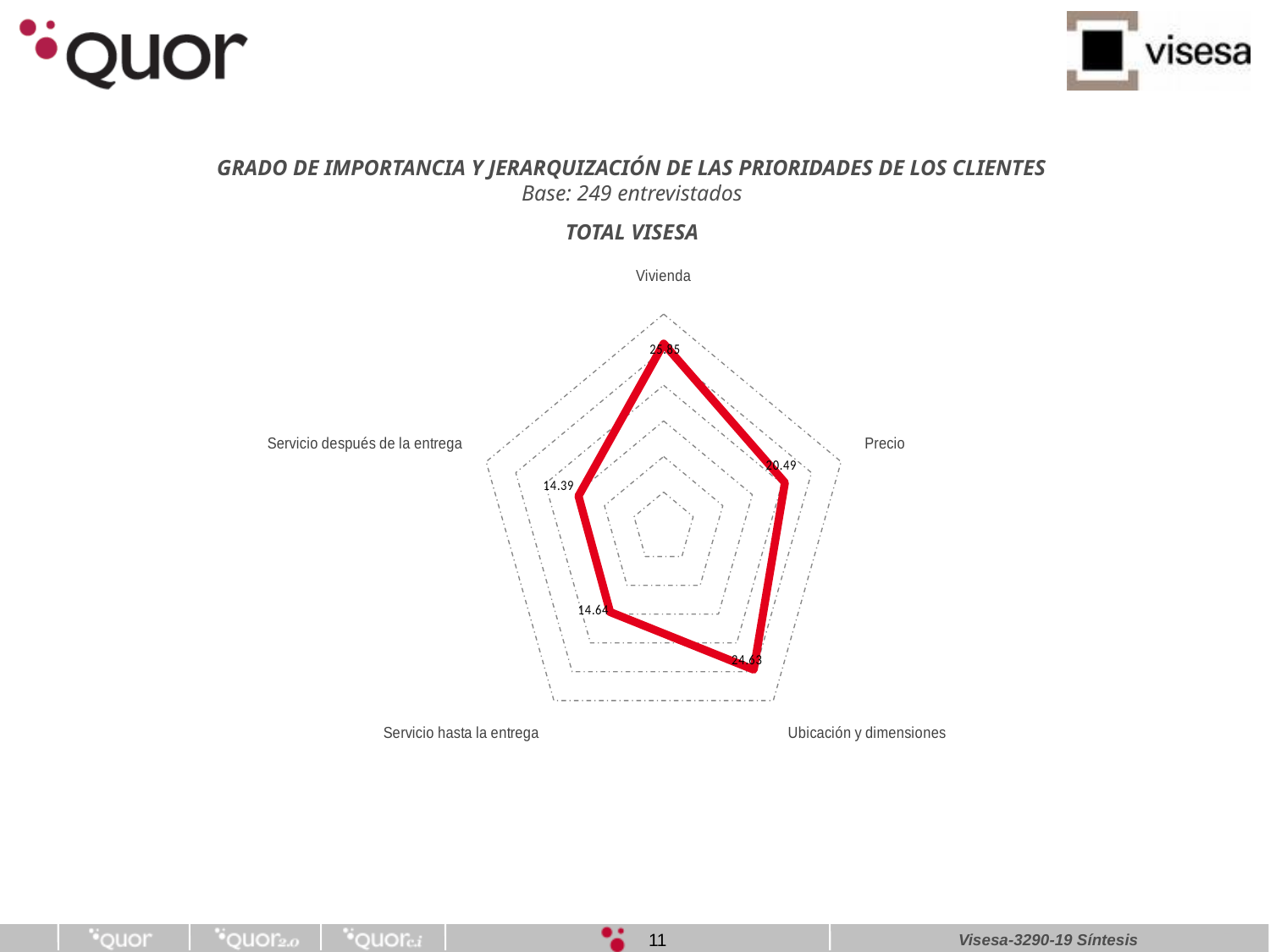
How many categories (axes) does the radar chart have? 5 What is the value for Servicio después de la entrega? 14.39 What is the difference between the values for Precio and Servicio después de la entrega? 6.10 What is the value for Servicio hasta la entrega? 14.64 What is the difference between the values for Ubicación y dimensiones and Precio? 4.14 What is the difference between the values for Servicio hasta la entrega and Servicio después de la entrega? 0.25 What is the base (number of interviewees) stated under the chart title? 249 entrevistados Which is larger, the value for Precio or the value for Servicio después de la entrega? Precio Which is larger, the value for Ubicación y dimensiones or the value for Servicio hasta la entrega? Ubicación y dimensiones What is the value for Precio on the radar chart? 20.49 What kind of chart is shown on the slide? Radar chart What is the value for Ubicación y dimensiones? 24.63